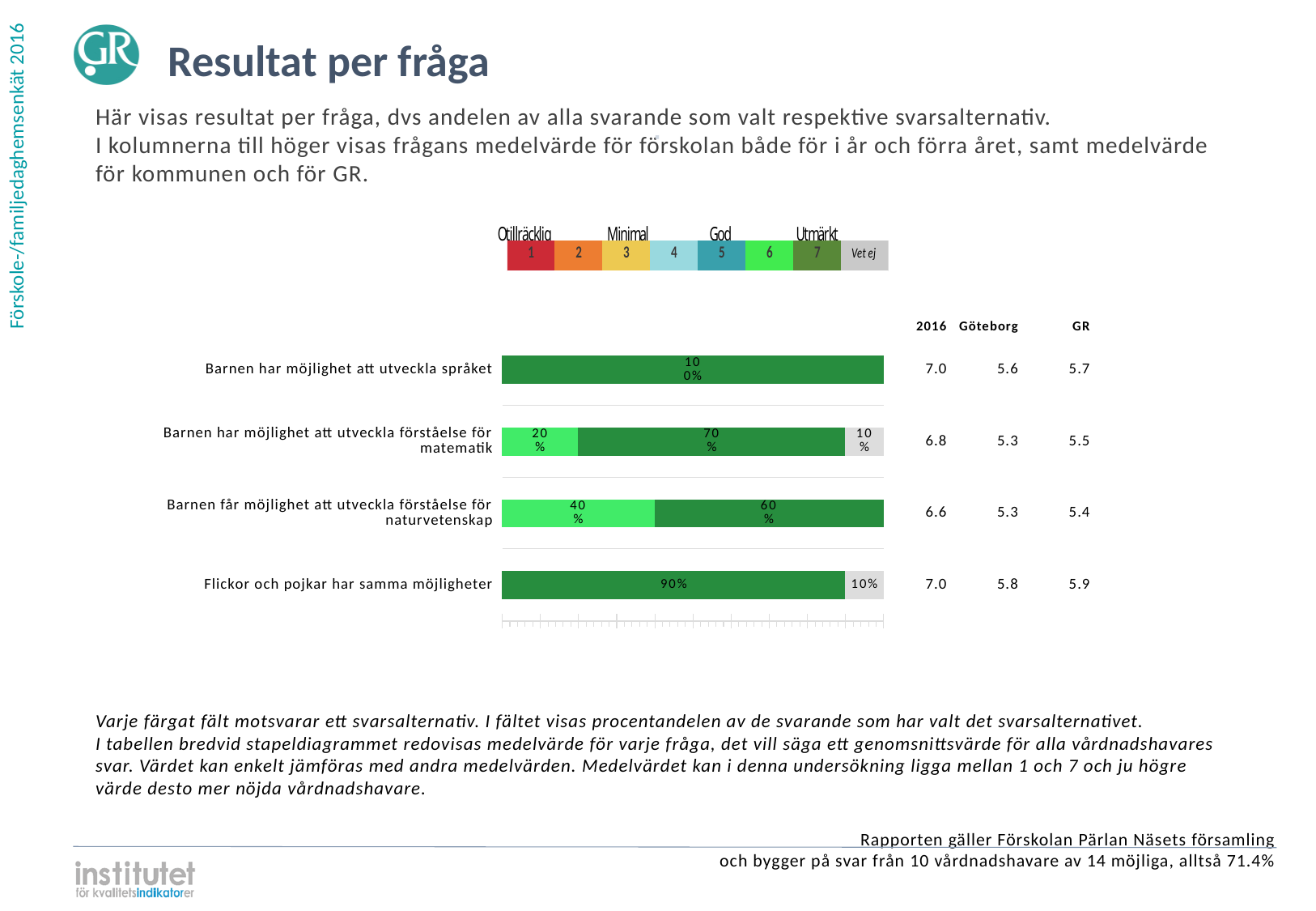
What is the 2016 mean value for 'Barnen har möjlighet att utveckla förståelse för matematik'? 6.8 What percentage of respondents answered 'Vet ej' for 'Flickor och pojkar har samma möjligheter'? 10% Which is larger for 'Barnen får möjlighet att utveckla förståelse för naturvetenskap': the share choosing 6 or the share choosing 7? 7 What percentage of respondents chose the dark green (7) alternative for 'Barnen har möjlighet att utveckla språket'? 100% What kind of chart is shown on the slide? stacked bar chart What is the GR mean value for 'Flickor och pojkar har samma möjligheter'? 5.9 What percentage of respondents chose the dark green (7) alternative for 'Barnen får möjlighet att utveckla förståelse för naturvetenskap'? 60% Which question has the lowest 2016 mean value? Barnen får möjlighet att utveckla förståelse för naturvetenskap What is the difference between the 2016 mean and the Göteborg mean for 'Barnen har möjlighet att utveckla språket'? 1.4 How many answer alternatives does the legend above the chart list? 8 What percentage of respondents chose the light green (6) alternative for 'Barnen har möjlighet att utveckla förståelse för matematik'? 20% How many questions (categories) are plotted in the bar chart? 4